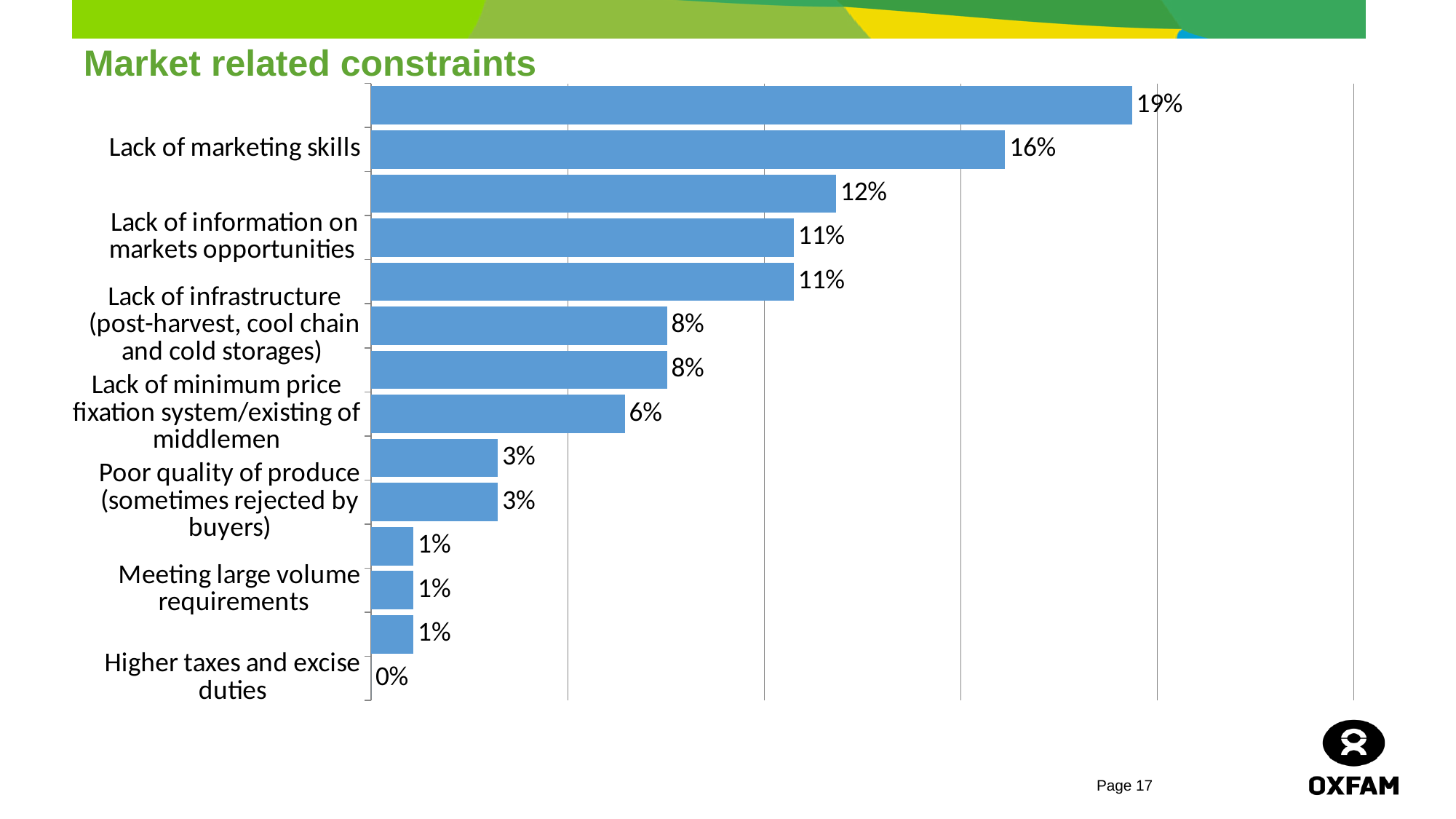
What is the value for "Lack of minimum price fixation system/existing of middlemen"? 6% What is the highest value shown on the chart? 19% What is the value for "Poor quality of produce (sometimes rejected by buyers)"? 3% What is the value for "Lack of infrastructure (post-harvest, cool chain and cold storages)"? 8% Which is larger: the value for "Lack of infrastructure (post-harvest, cool chain and cold storages)" or for "Poor quality of produce (sometimes rejected by buyers)"? Lack of infrastructure (post-harvest, cool chain and cold storages) What is the value for "Higher taxes and excise duties"? 0% What is the value for "Lack of marketing skills"? 16% What is the value for "Lack of information on markets opportunities"? 11% What is the difference between the values for "Lack of marketing skills" and "Lack of information on markets opportunities"? 5% Which labelled category has the lowest value? Higher taxes and excise duties How many bars are plotted on the chart? 14 What is the value for "Meeting large volume requirements"? 1%